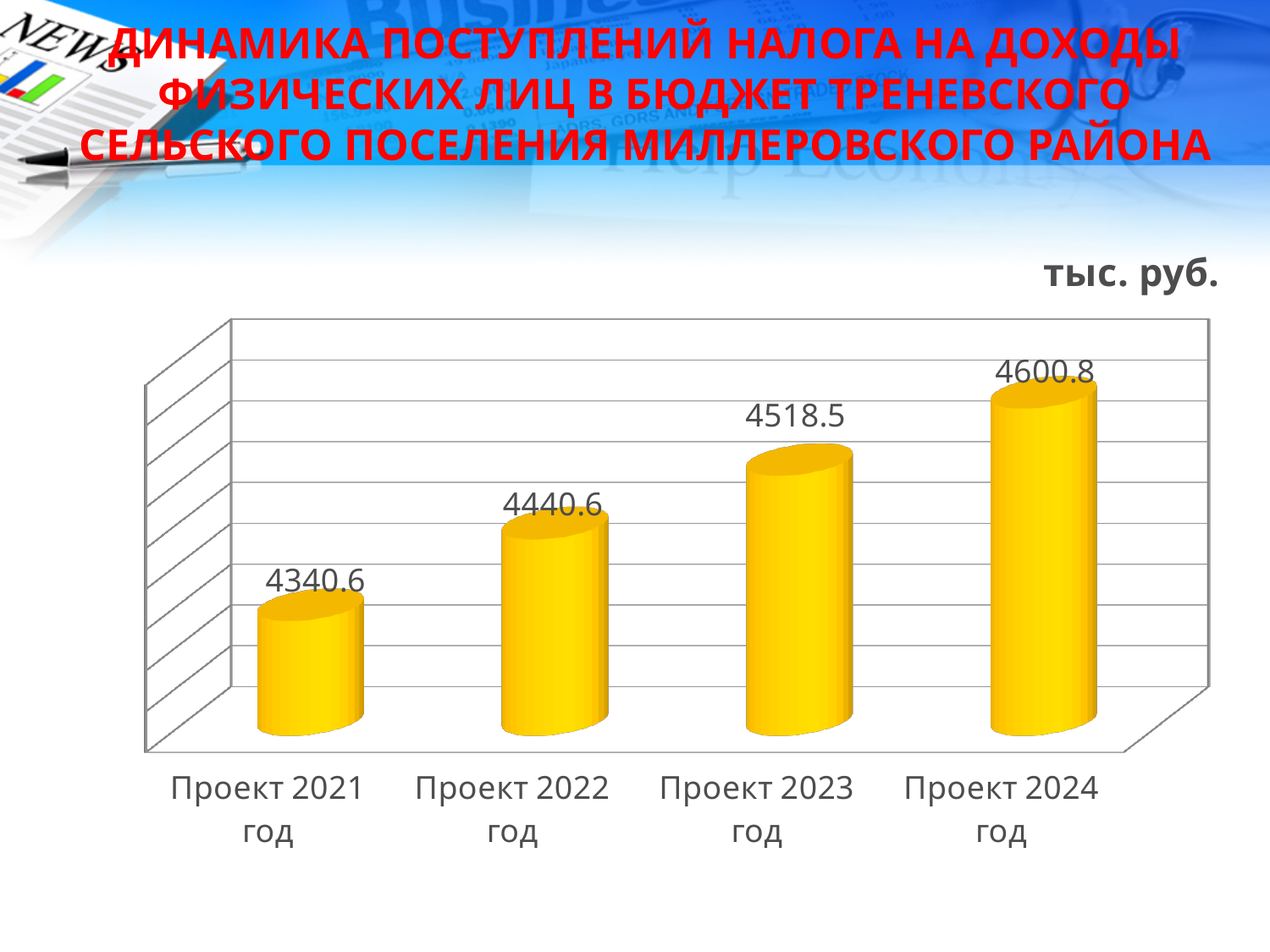
What is the value for Проект 2024 год? 4600.8 What is the difference between the values for Проект 2024 год and Проект 2021 год? 260.2 What kind of chart is shown on the slide? bar chart Which is larger, the value for Проект 2022 год or Проект 2023 год? Проект 2023 год Which category has the lowest value? Проект 2021 год How many categories are shown in the chart? 4 What is the difference between the values for Проект 2022 год and Проект 2021 год? 100 Do the values rise or fall from Проект 2021 год to Проект 2024 год? rise What is the value for Проект 2023 год? 4518.5 What is the value for Проект 2021 год? 4340.6 What unit is indicated for the values in the chart? тыс. руб. Which category has the highest value? Проект 2024 год